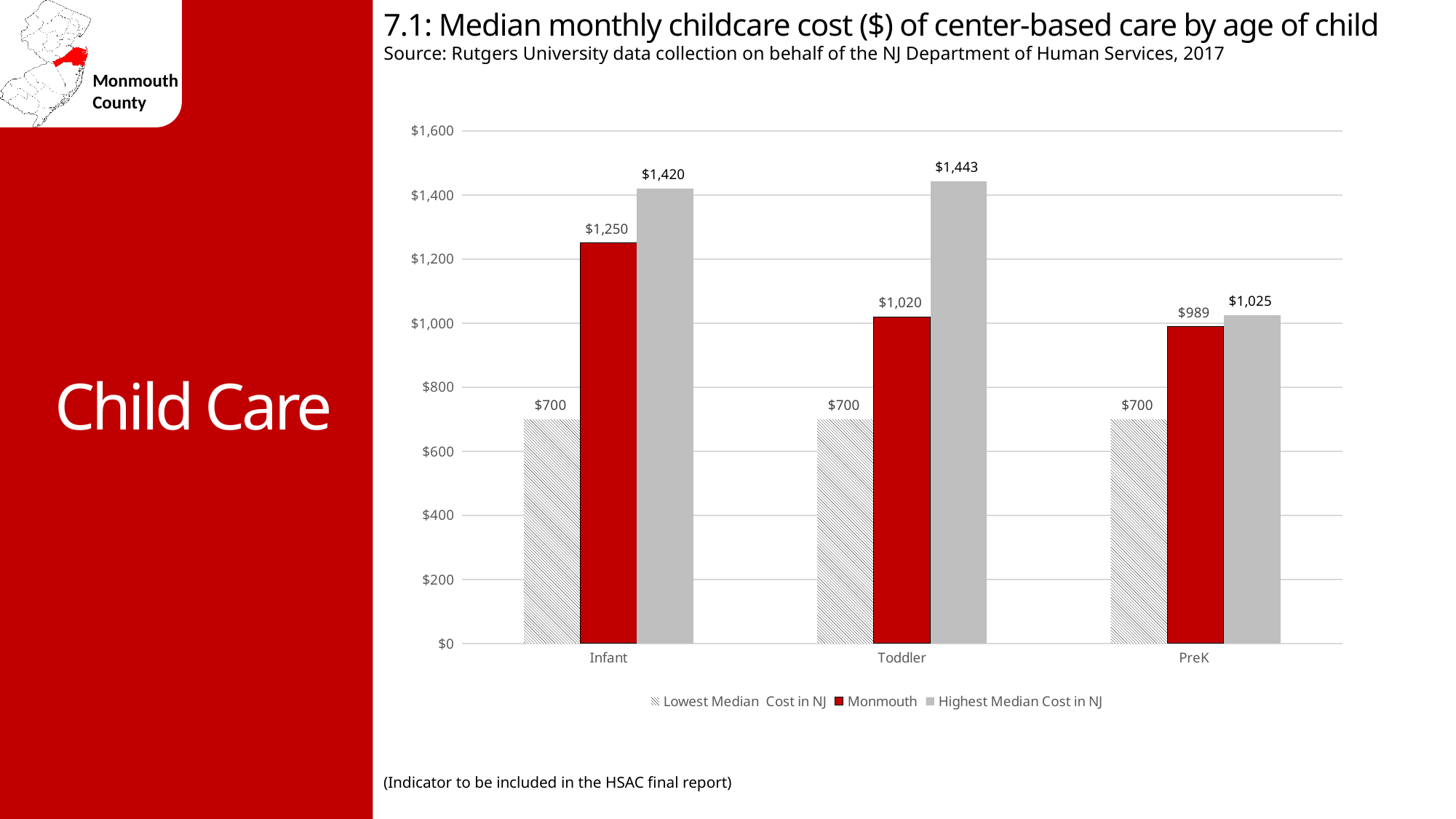
What is the Highest Median Cost in NJ for Toddler care? $1,443 What is the Monmouth value for PreK? $989 How many age groups are shown on the x axis? 3 What is the Lowest Median Cost in NJ for Infant care? $700 What is the difference between the Highest Median Cost in NJ and the Monmouth cost for Infant care? $170 What kind of chart is shown on the slide? Bar chart How many series does the legend list? 3 For which age group is the Monmouth cost highest? Infant Which is larger: the Monmouth cost for Toddler or the Monmouth cost for PreK? Monmouth cost for Toddler What is the Monmouth median monthly childcare cost for Infant care? $1,250 For which age group is the Highest Median Cost in NJ lowest? PreK What is the difference between the Monmouth cost for Infant and the Monmouth cost for Toddler? $230